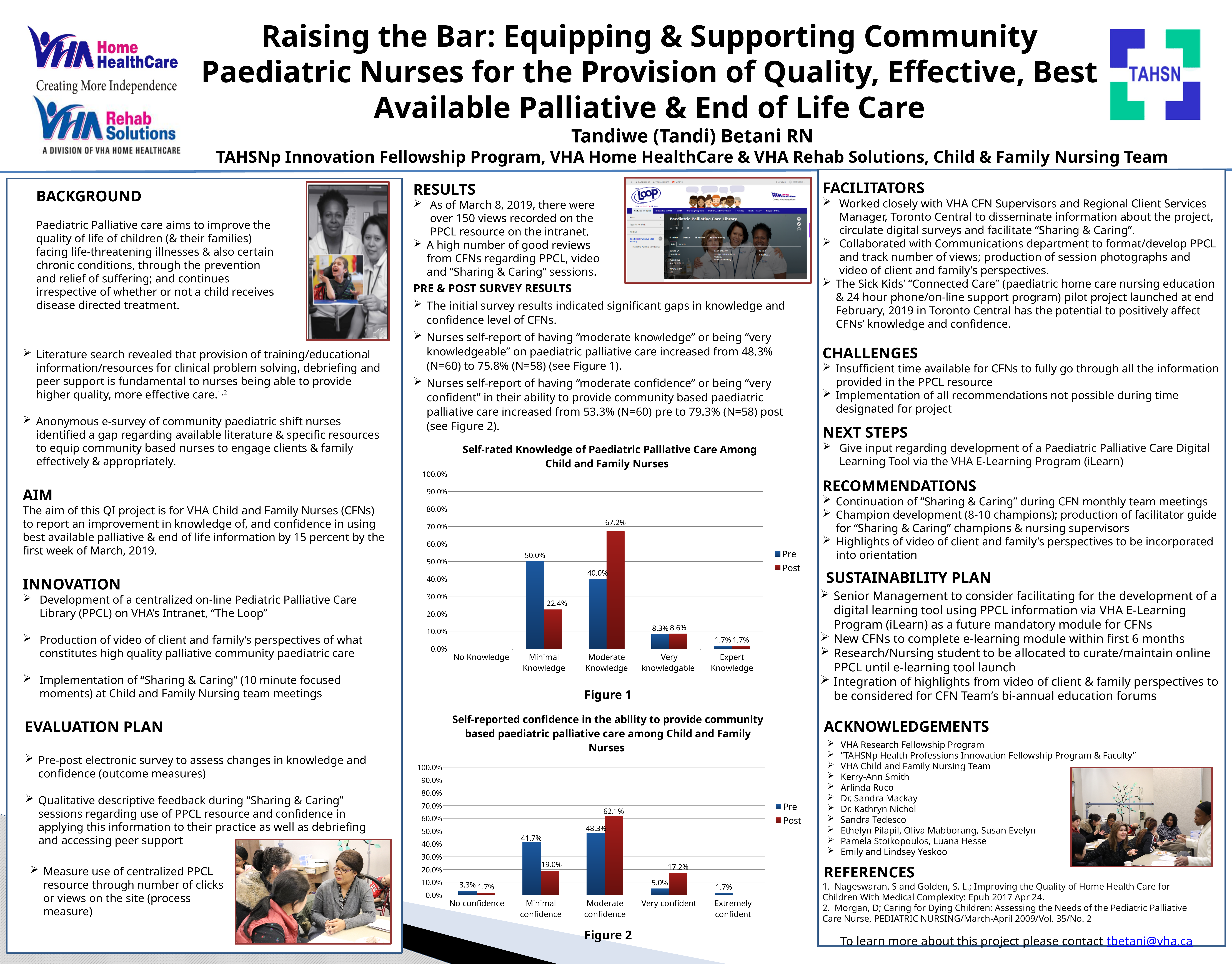
In Figure 1 (Self-rated Knowledge), which category has the highest Post value? Moderate Knowledge In Figure 2 (Self-reported confidence), what is the Post value for Very confident? 17.2% In Figure 1 (Self-rated Knowledge), how many knowledge categories are shown on the x axis? 5 What type of chart is Figure 2 (Self-reported confidence)? Bar chart In Figure 1 (Self-rated Knowledge), what is the Pre value for Minimal Knowledge? 50.0% In Figure 1 (Self-rated Knowledge), what is the difference between the Pre and Post values for Minimal Knowledge? 27.6% In Figure 1 (Self-rated Knowledge of Paediatric Palliative Care), what is the Post value for Moderate Knowledge? 67.2% In Figure 2 (Self-reported confidence), which category has the lowest Pre value? Extremely confident In Figure 2 (Self-reported confidence), which is larger for Minimal confidence, the Pre value or the Post value? Pre In Figure 1 (Self-rated Knowledge), how many series does the legend list? 2 In Figure 2 (Self-reported confidence), what is the Pre value for Moderate confidence? 48.3% In Figure 2 (Self-reported confidence), what is the difference between the Post and Pre values for Moderate confidence? 13.8%